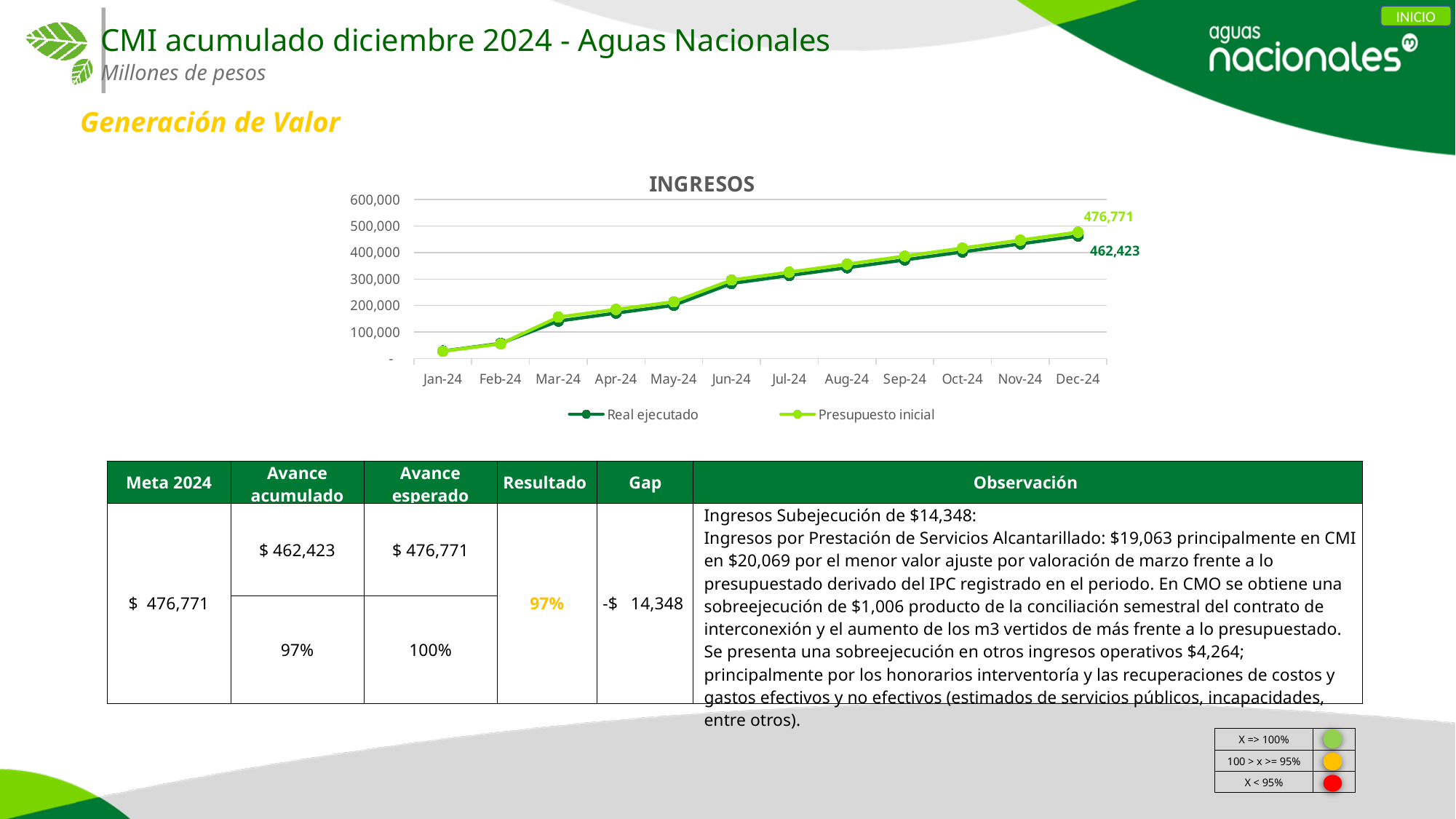
Do the values of Real ejecutado rise or fall from Jan-24 to Dec-24 in the INGRESOS chart? rise How many series does the legend of the INGRESOS chart list? 2 In the INGRESOS chart, is the value of Real ejecutado at Jan-24 greater or less than 100,000? less At Dec-24 in the INGRESOS chart, which series is larger, Real ejecutado or Presupuesto inicial? Presupuesto inicial In the INGRESOS chart, is the value of Presupuesto inicial at Jun-24 greater or less than 200,000? greater What is the value of Presupuesto inicial at Dec-24 in the INGRESOS chart? 476,771 What is the value of Real ejecutado at Dec-24 in the INGRESOS chart? 462,423 What are the two legend entries of the INGRESOS chart? Real ejecutado and Presupuesto inicial In which month does Real ejecutado reach its highest value in the INGRESOS chart? Dec-24 What kind of chart is the INGRESOS chart? line chart In the INGRESOS chart, what is the difference between Presupuesto inicial and Real ejecutado at Dec-24? 14,348 How many months are plotted along the x axis of the INGRESOS chart? 12